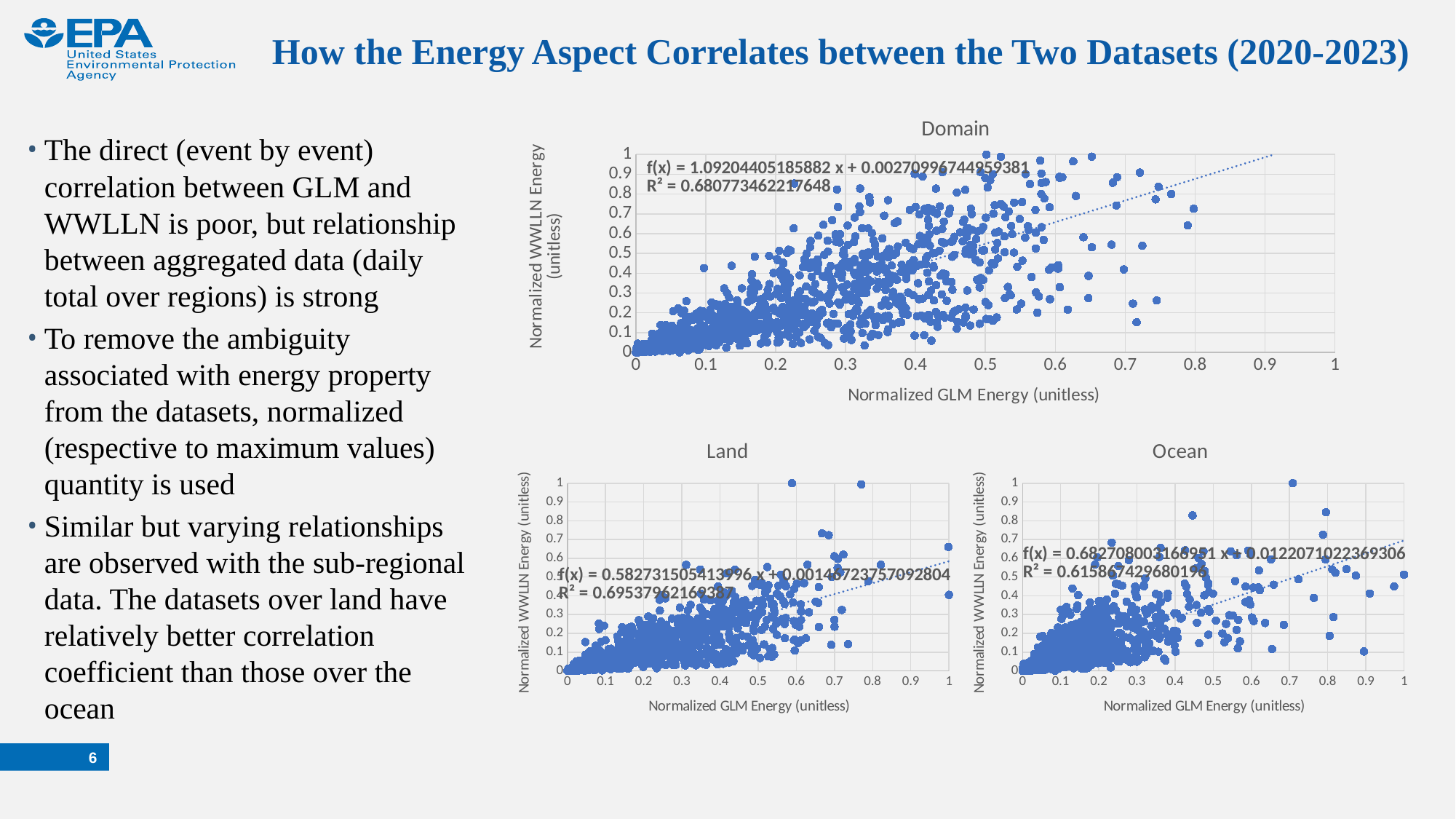
Which of the three charts (Domain, Land, Ocean) shows the lowest R² value? Ocean What kind of chart is the Domain chart? Scatter chart Is the R² value on the Ocean chart greater or less than 0.7? less What is the intercept of the trendline equation printed on the Domain chart? 0.00270996744959381 What is the slope of the trendline equation printed on the Domain chart? 1.09204405185882 How many charts are shown on the slide? 3 Is the R² value on the Land chart larger or smaller than the R² value on the Ocean chart? Larger What is the R² value printed on the Domain chart? 0.680773462217648 What is the y-axis title of the Ocean chart? Normalized WWLLN Energy (unitless) Which of the three charts (Domain, Land, Ocean) shows the highest R² value? Land Is the trendline slope on the Domain chart greater or less than 1? greater What is the x-axis title of the Land chart? Normalized GLM Energy (unitless)